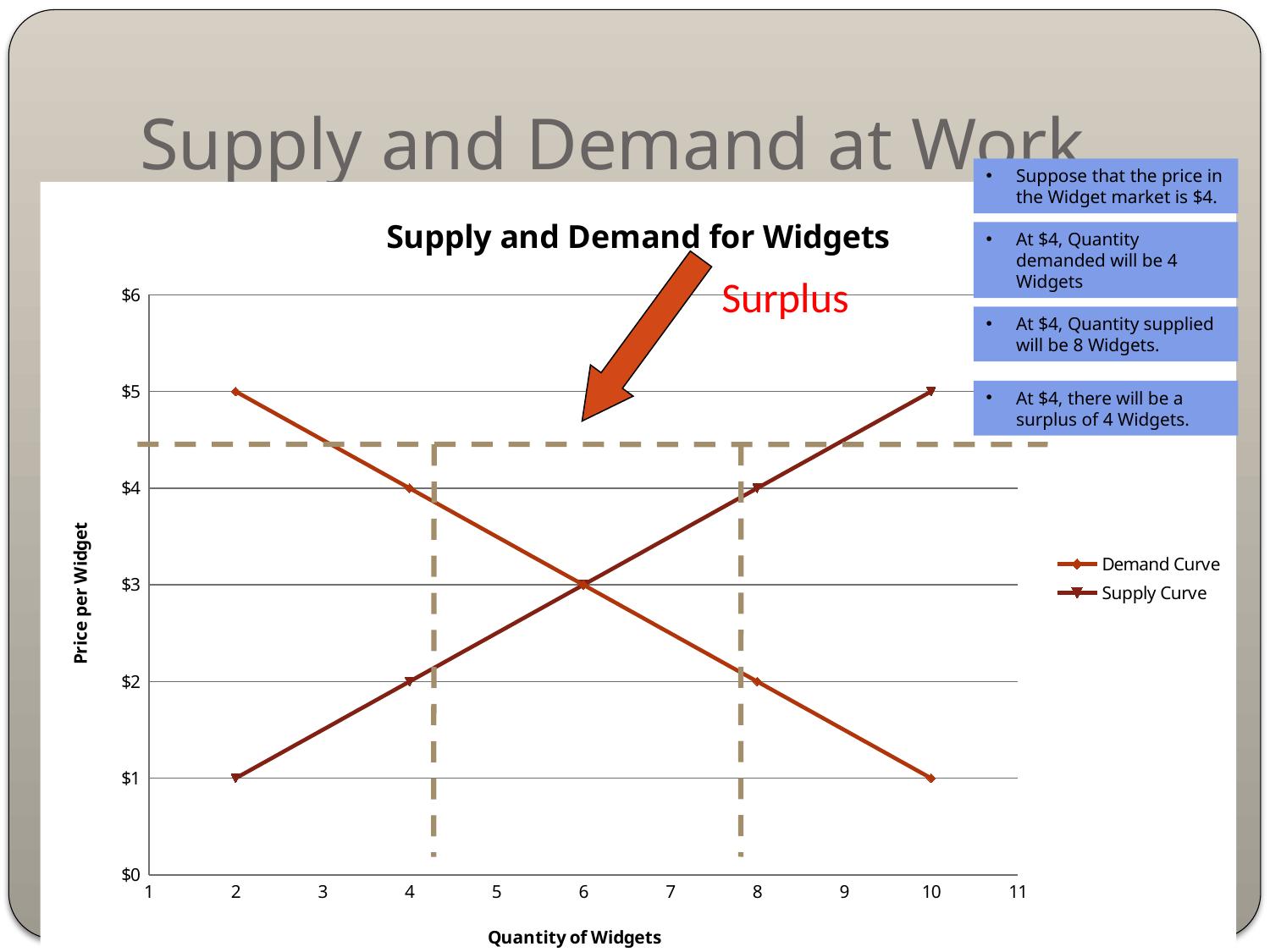
What is the price on the Demand Curve at a quantity of 10 widgets? $1 What is the title of the chart? Supply and Demand for Widgets What is the price on the Demand Curve at a quantity of 4 widgets? $4 What is the price on the Supply Curve at a quantity of 8 widgets? $4 What is the label on the y axis of the chart? Price per Widget What is the difference in price between the Demand Curve and the Supply Curve at a quantity of 2 widgets? $4 At a quantity of 2 widgets, which curve has the higher price, the Demand Curve or the Supply Curve? Demand Curve Does the Supply Curve rise or fall as quantity increases along the x axis? Rise At what quantity do the Demand Curve and Supply Curve intersect? 6 How many series does the chart legend list? 2 What kind of chart is shown on the slide? Line chart Does the Demand Curve rise or fall as quantity increases along the x axis? Fall